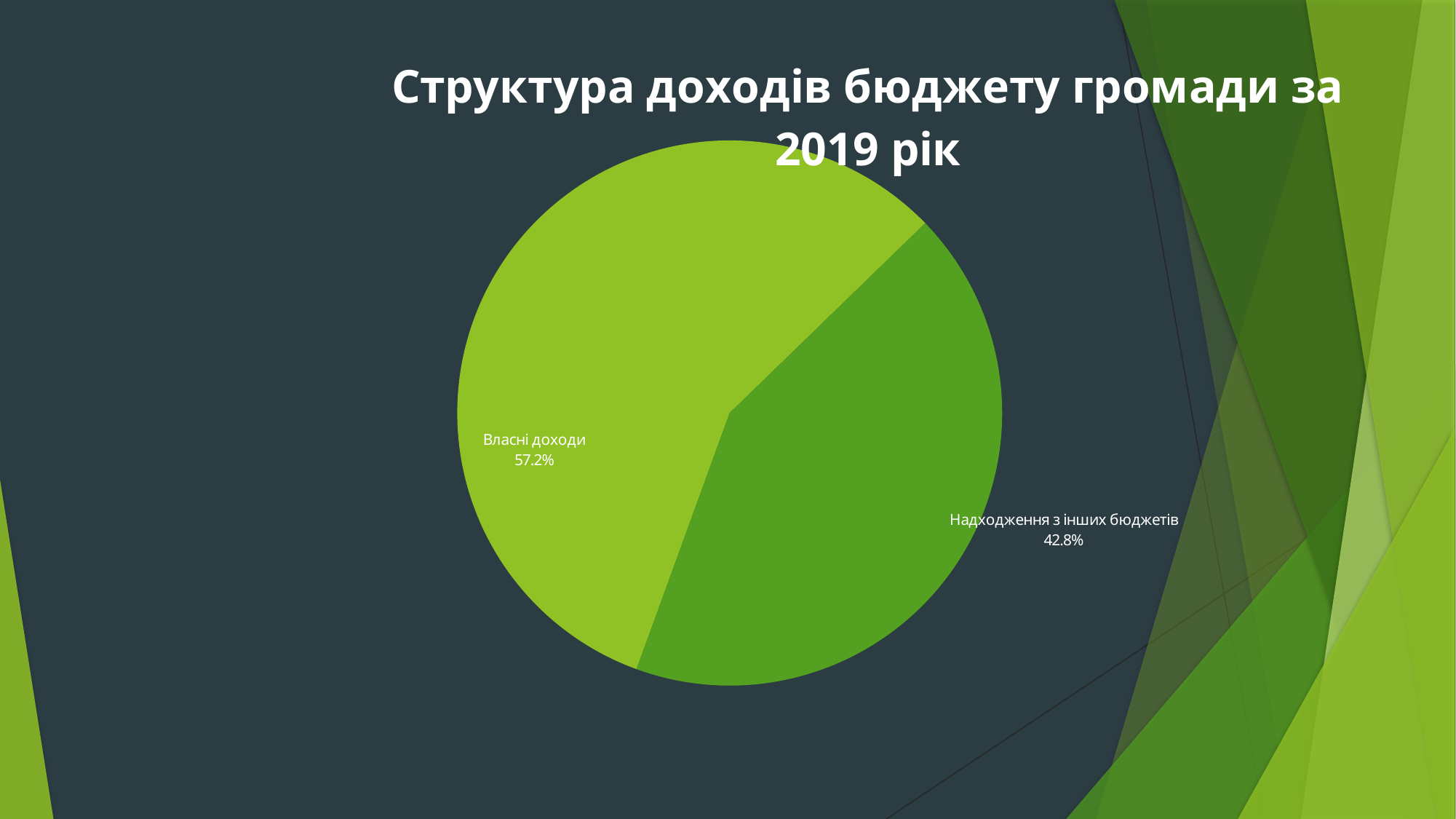
What type of chart is shown on the slide? pie chart How many slices does the pie chart have? 2 Which year does the chart title refer to? 2019 Which slice is the smallest in the pie chart? Надходження з інших бюджетів Which is larger: "Власні доходи" or "Надходження з інших бюджетів"? Власні доходи What share of the pie does "Власні доходи" represent? 57.2% Is the share for "Власні доходи" greater or less than 50%? greater What is the difference in percentage points between "Власні доходи" and "Надходження з інших бюджетів"? 14.4 Which slice is the largest in the pie chart? Власні доходи What is the title of the chart? Структура доходів бюджету громади за 2019 рік What share of the pie does "Надходження з інших бюджетів" represent? 42.8%